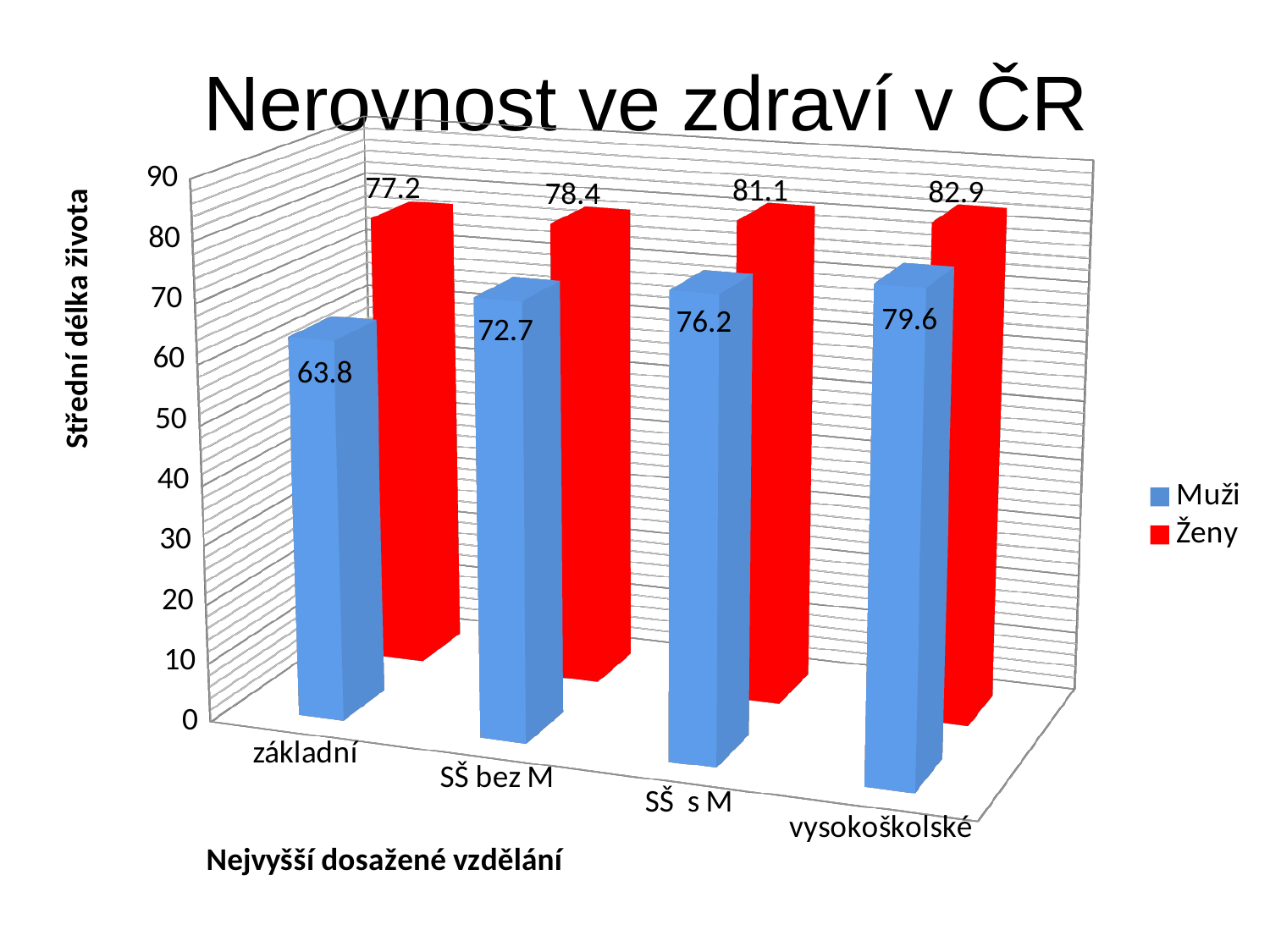
How many categories are shown on the x axis? 4 Do the Muži values rise or fall from základní to vysokoškolské? rise What is the difference between the Ženy and Muži values in the základní category? 13.4 What is the value for Ženy in the SŠ bez M category? 78.4 Which is larger: the Muži value for SŠ bez M or the Muži value for SŠ s M? SŠ s M What is the difference between the Muži values for vysokoškolské and základní? 15.8 What is the value for Muži in the SŠ s M category? 76.2 What is the value for Muži in the základní category? 63.8 Which category has the lowest value for Ženy? základní What is the value for Ženy in the vysokoškolské category? 82.9 How many series does the legend list? 2 Which category has the highest value for Muži? vysokoškolské